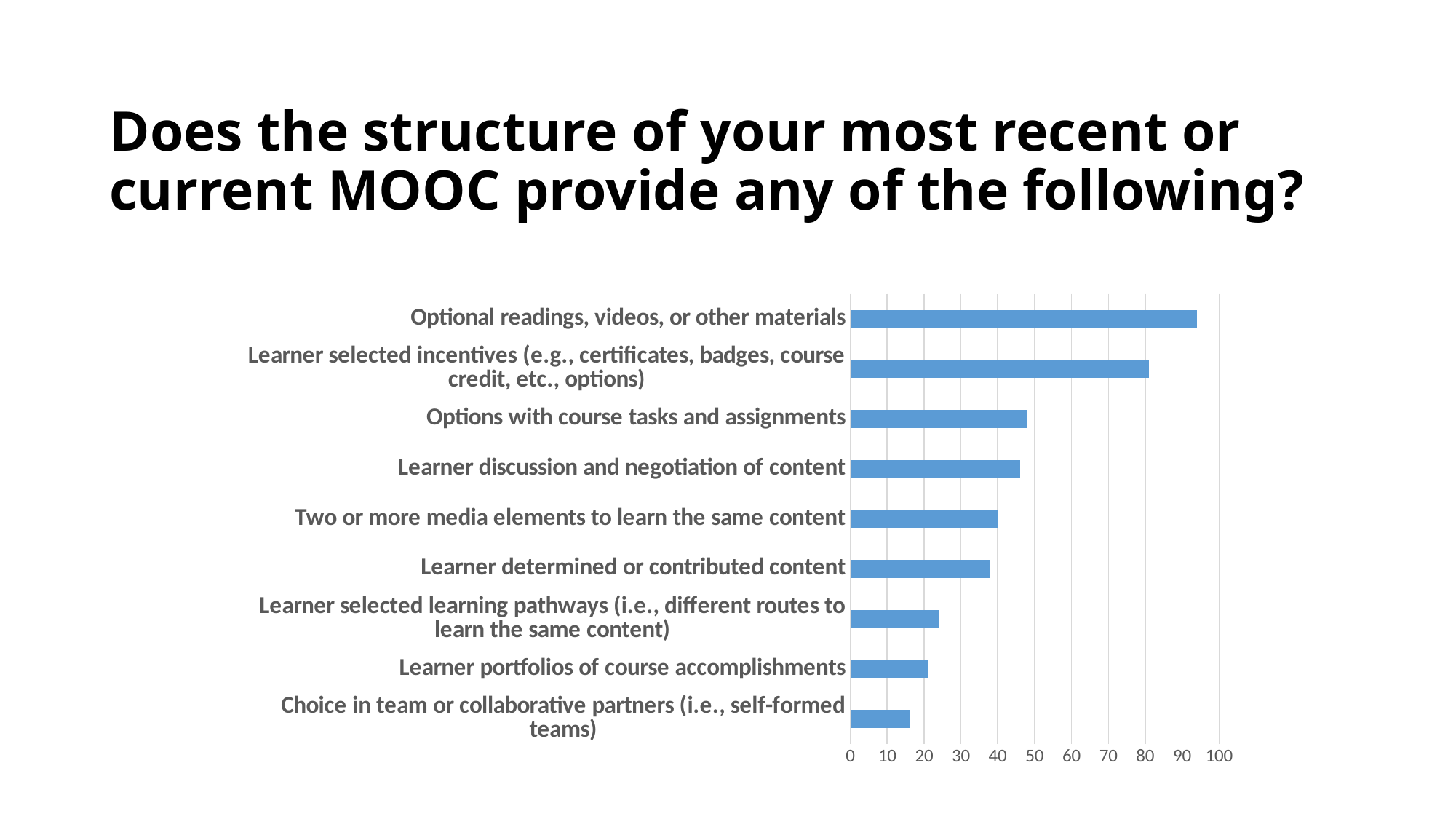
Which is larger: the value for Learner selected incentives or the value for Options with course tasks and assignments? Learner selected incentives How many categories are plotted in the chart? 9 Which is larger: the value for Learner determined or contributed content or the value for Learner selected learning pathways? Learner determined or contributed content Is the value for Optional readings, videos, or other materials greater or less than 90? greater Is the value for Choice in team or collaborative partners (i.e., self-formed teams) greater or less than 20? less What is the maximum value shown on the horizontal axis? 100 Is the value for Learner selected incentives (e.g., certificates, badges, course credit, etc., options) greater or less than 90? less What kind of chart is shown on the slide? bar chart Which category has the lowest value? Choice in team or collaborative partners (i.e., self-formed teams) Which category has the highest value? Optional readings, videos, or other materials